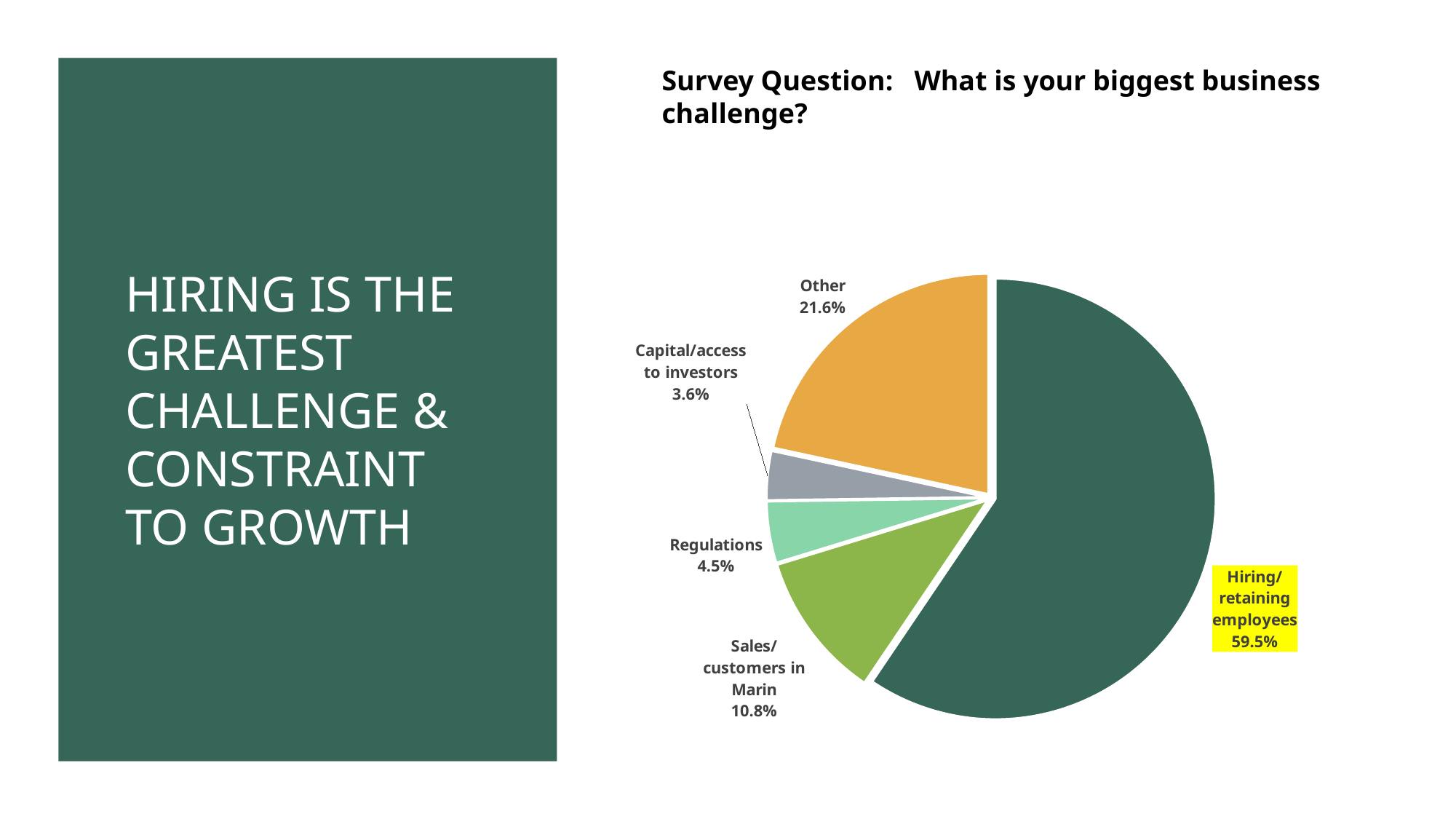
What percentage is shown for Sales/customers in Marin? 10.8% Which category has the smallest slice of the pie? Capital/access to investors What share of respondents chose Hiring/retaining employees as their biggest business challenge? 59.5% What percentage is shown for the Other slice? 21.6% Which category has the largest slice of the pie? Hiring/retaining employees What survey question does the pie chart answer? What is your biggest business challenge? What is the difference in percentage points between Hiring/retaining employees and Other? 37.9 How many slices does the pie chart have? 5 What percentage is shown for Capital/access to investors? 3.6% What percentage is shown for Regulations? 4.5% What kind of chart is shown on the slide? pie chart Which is larger, the share for Regulations or the share for Sales/customers in Marin? Sales/customers in Marin